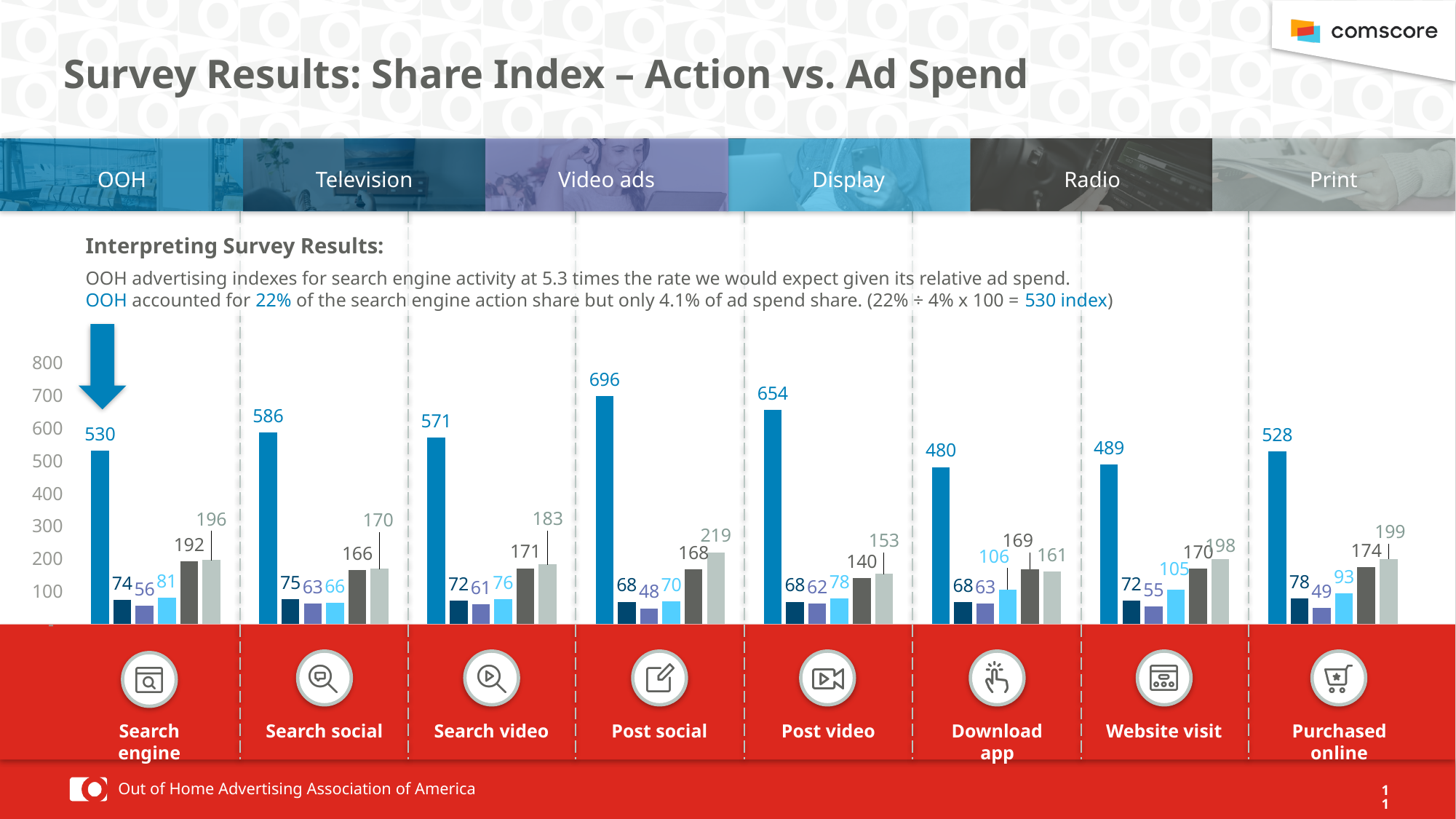
What kind of chart is shown on the slide? Bar chart What is the title of the slide's chart? Survey Results: Share Index – Action vs. Ad Spend What is the Radio index value for Post video? 140 Which is larger: the Print index for Post social or the Print index for Search engine? Post social What is the Display index value for Download app? 106 How many media series (OOH, Television, etc.) are plotted in the chart? 6 Which action has the lowest Video ads index value? Post social Which action has the highest OOH index value? Post social What is the difference between the OOH index for Post social and the OOH index for Search engine? 166 Which action has the lowest OOH index value? Download app What is the OOH index value for Post social? 696 How many actions (categories) are shown along the x axis of the chart? 8